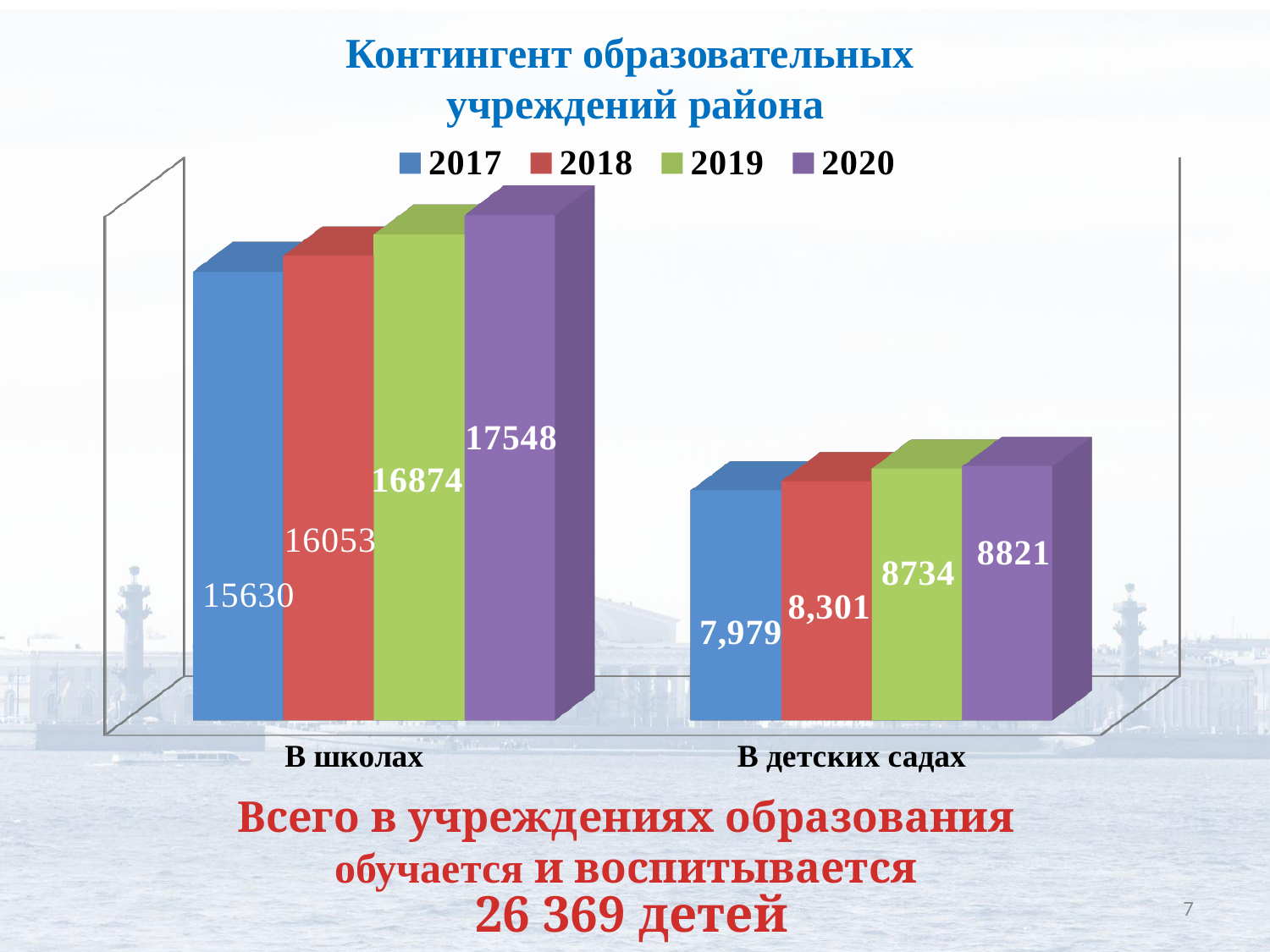
What is the value for 2019 in the 'В детских садах' category? 8734 Which year has the highest value in the 'В школах' category? 2020 What is the value for 2017 in the 'В детских садах' category? 7,979 What is the value for 2020 in the 'В школах' category? 17548 How many series does the legend list? 4 What is the value for 2018 in the 'В школах' category? 16053 How many categories are shown on the x axis? 2 What kind of chart is shown on the slide? Bar chart Which year has the lowest value in the 'В детских садах' category? 2017 What is the difference between the 2020 and 2017 values in the 'В детских садах' category? 842 What is the difference between the 2020 and 2017 values in the 'В школах' category? 1918 Which is larger: the 2019 value for 'В школах' or the 2019 value for 'В детских садах'? В школах